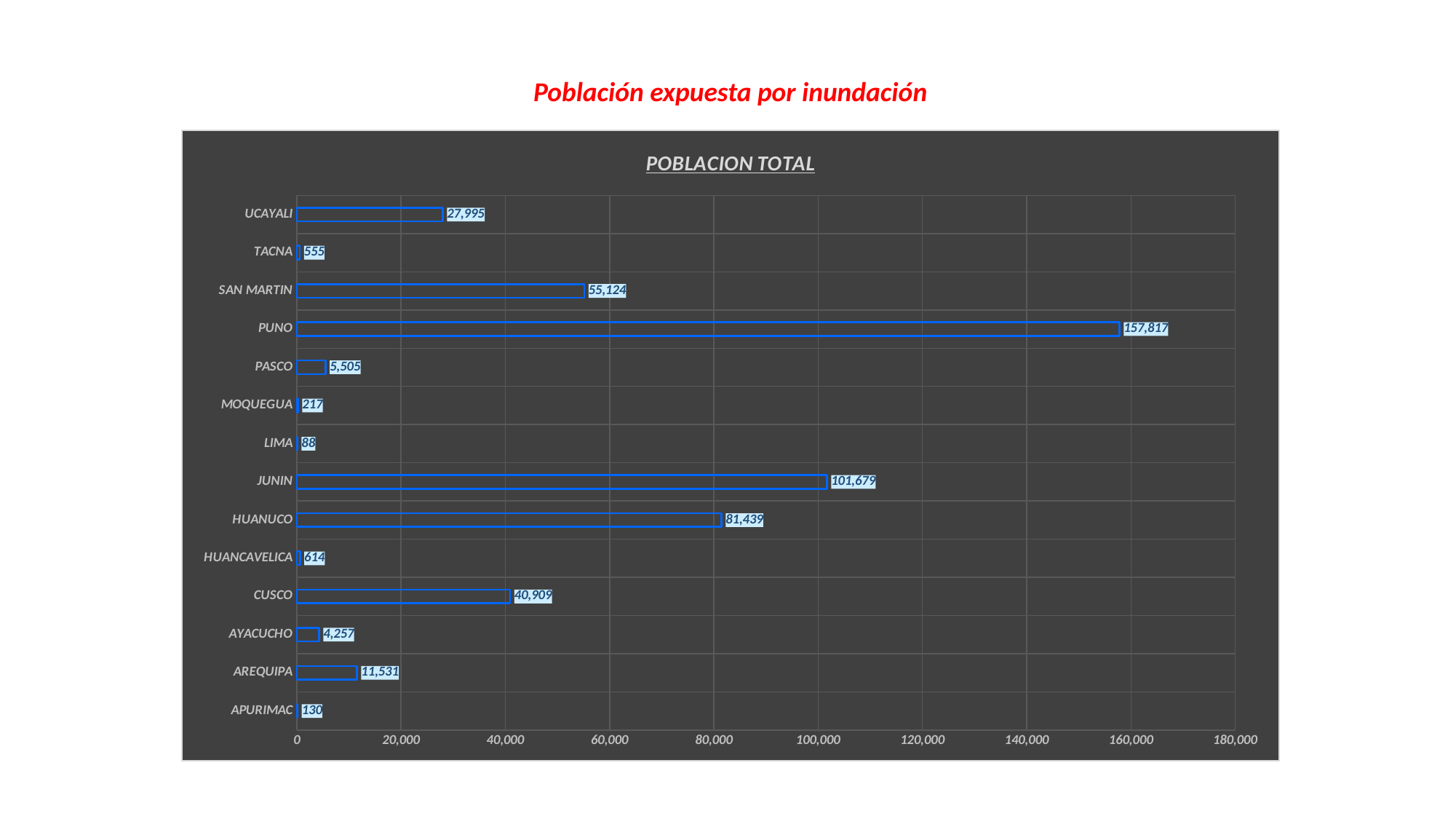
Which category has the highest value? PUNO What kind of chart is shown? bar chart What is the difference between the values for JUNIN and HUANUCO? 20,240 What is the value for PUNO? 157,817 Which is larger, the value for SAN MARTIN or the value for CUSCO? SAN MARTIN What is the value for HUANUCO? 81,439 What is the title of the chart? POBLACION TOTAL Which category has the lowest value? LIMA Is the value for JUNIN greater or less than 100,000? greater What is the value for LIMA? 88 What is the value for AREQUIPA? 11,531 How many categories are shown in the chart? 14